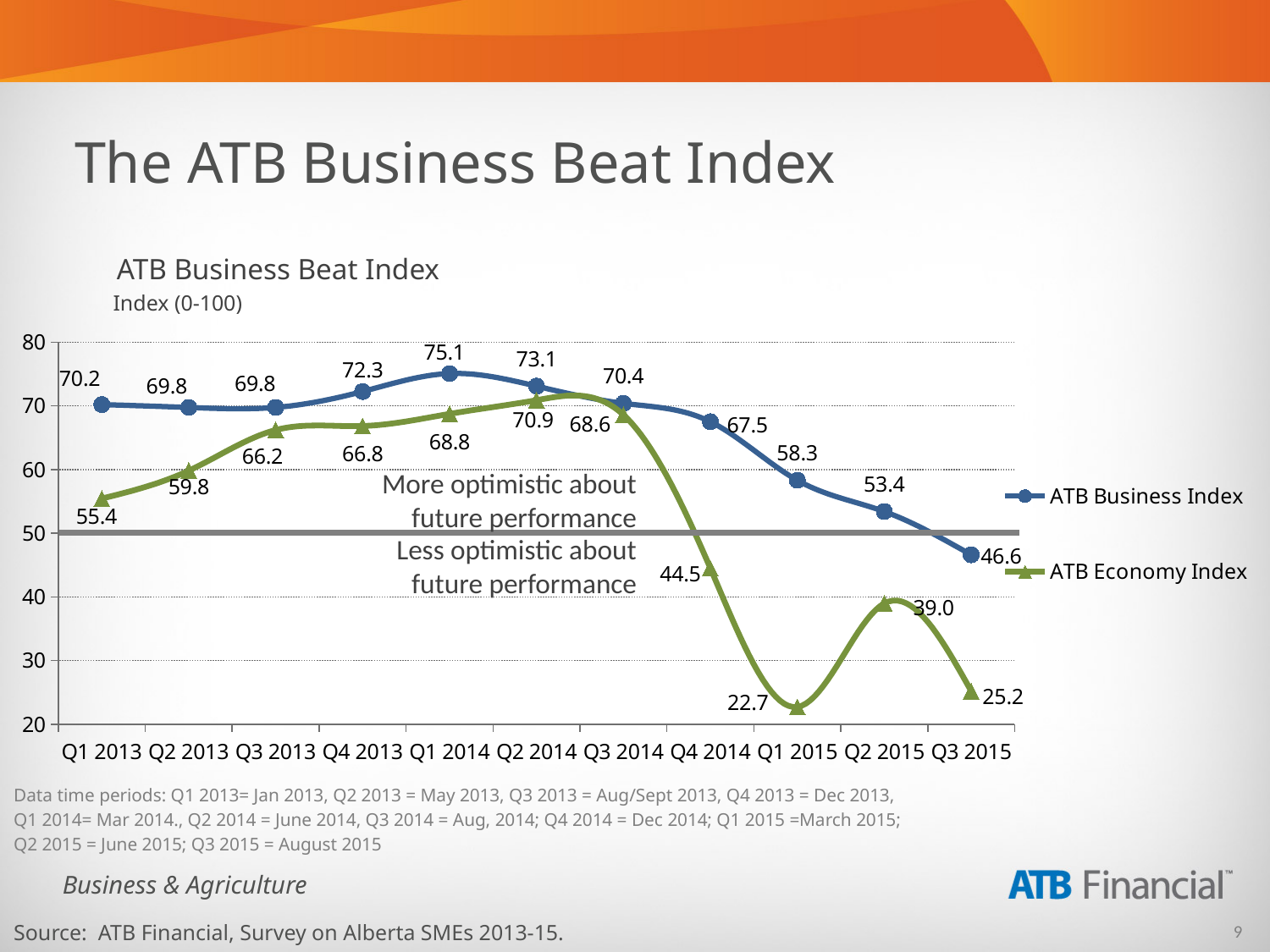
What are the two series named in the legend? ATB Business Index and ATB Economy Index What is the difference between the ATB Economy Index in Q2 2015 and Q3 2015? 13.8 What kind of chart is shown on the slide? Line chart How many series does the legend list? 2 How many quarters are plotted on the x axis? 11 In which quarter does the ATB Business Index reach its highest value? Q1 2014 In Q3 2014, which series has the higher value, the ATB Business Index or the ATB Economy Index? ATB Business Index What is the value of the ATB Business Index in Q1 2014? 75.1 What is the value of the ATB Economy Index in Q1 2015? 22.7 In which quarter does the ATB Economy Index reach its lowest value? Q1 2015 Does the ATB Business Index rise or fall from Q3 2014 to Q3 2015? Fall By how much did the ATB Business Index fall from Q1 2014 to Q3 2015? 28.5